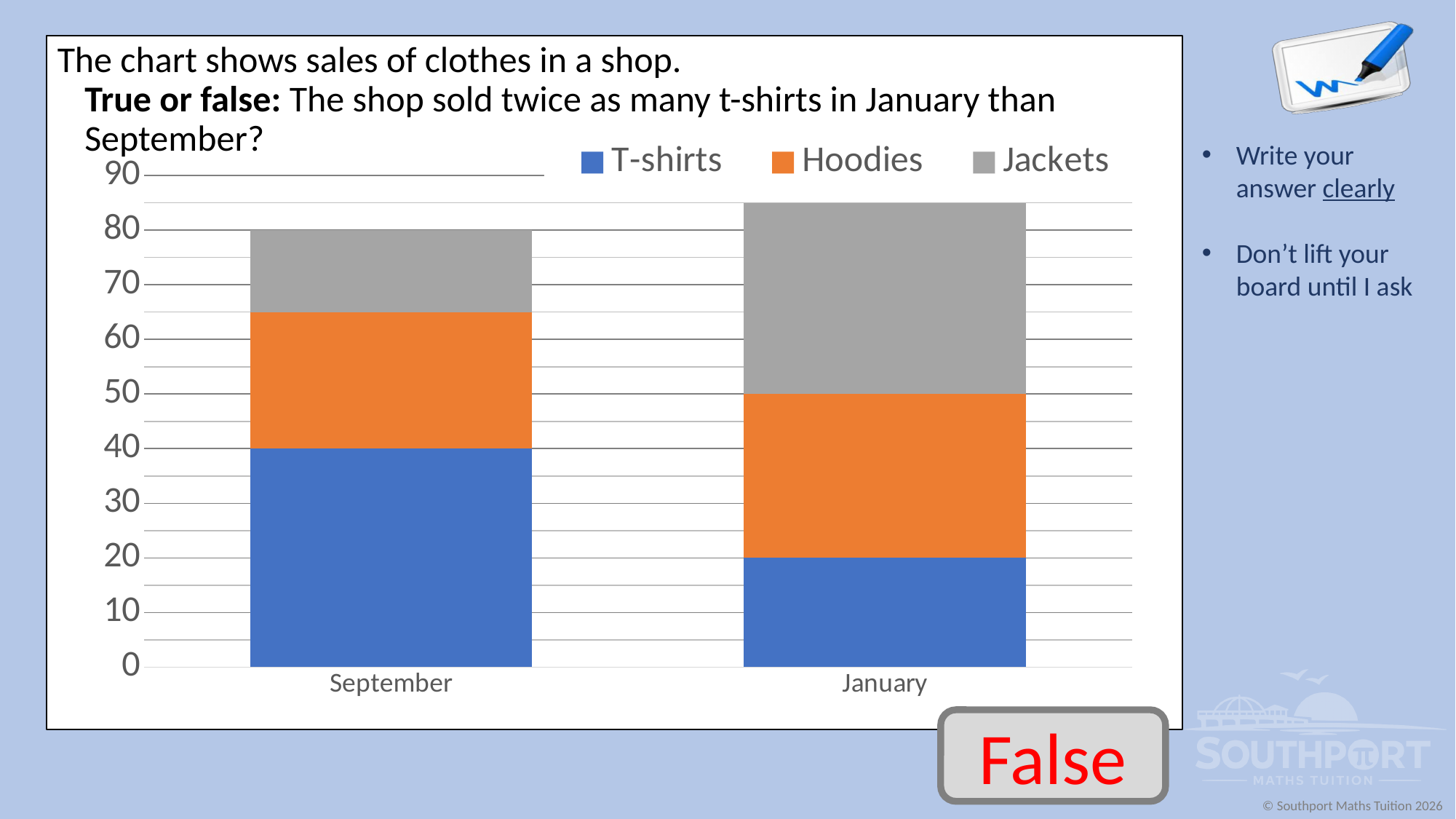
What is the total of the stacked bar for September? 80 Which month has the larger value for T-shirts, September or January? September What is the value for T-shirts in January? 20 Which month has the larger value for Jackets, September or January? January Is the value for Jackets in January greater or less than 30? greater How many series does the chart's legend list? 3 What is the difference between the T-shirts value in September and the T-shirts value in January? 20 What kind of chart is shown on the slide? bar chart What is the value for T-shirts in September? 40 What are the three series listed in the chart's legend? T-shirts, Hoodies, Jackets Is the total of the stacked bar for January greater or less than 80? greater How many categories are shown on the x axis of the chart? 2